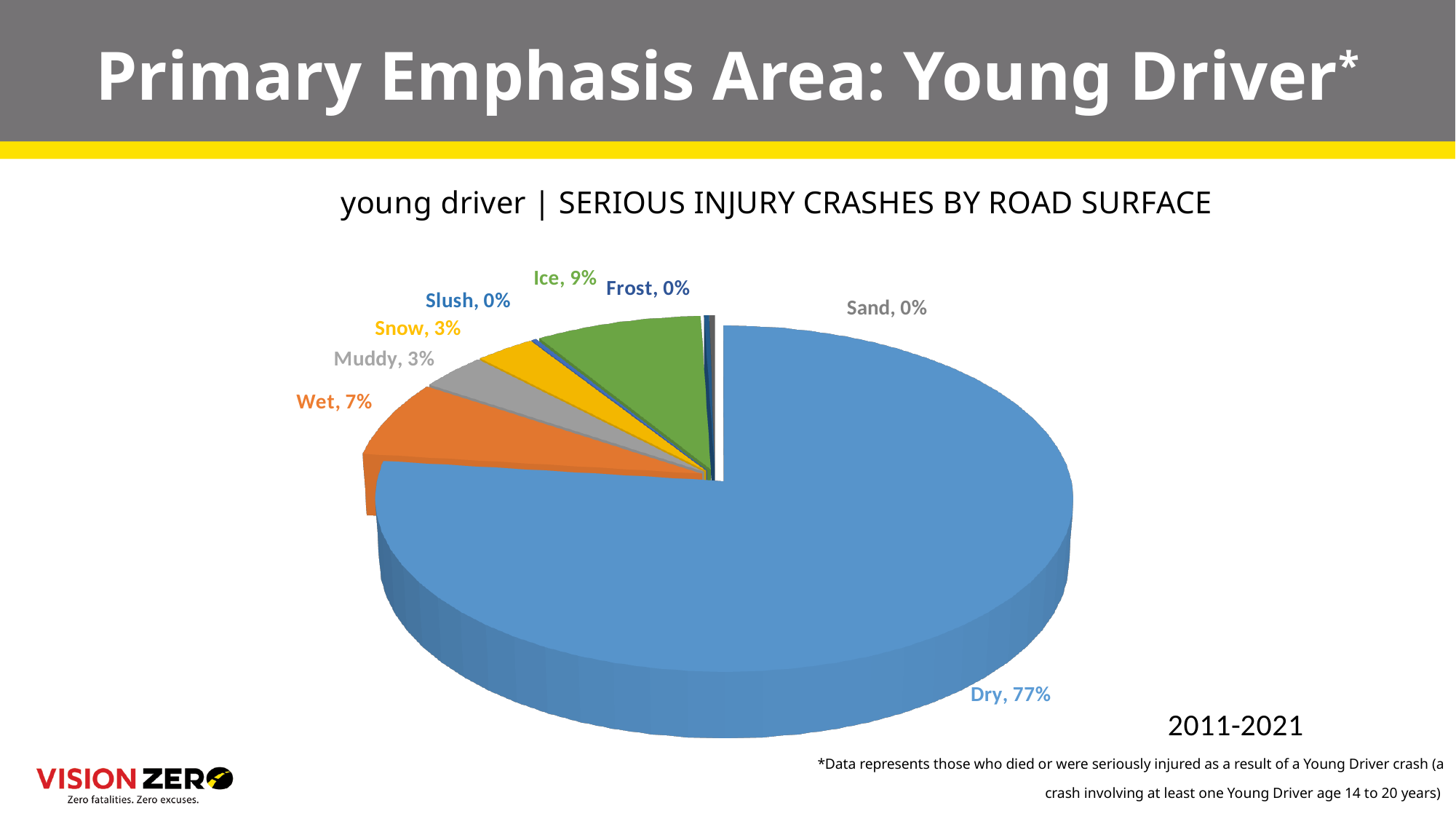
What is the title of the chart? young driver | SERIOUS INJURY CRASHES BY ROAD SURFACE What kind of chart is shown on the slide? Pie chart Which road surface category has the largest share of serious injury crashes? Dry How many road surface categories are labelled on the pie chart? 8 What percentage is shown for the Wet road surface? 7% What percentage is shown for the Snow road surface? 3% What percentage of serious injury crashes is shown for the Ice road surface? 9% What is the difference in percentage points between the Dry share and the Ice share? 68 percentage points What share of young driver serious injury crashes occurred on a dry road surface? 77% Which has a larger share, Ice or Wet? Ice What percentage is shown for the Frost road surface? 0% What time period does the chart cover, as shown on the slide? 2011-2021